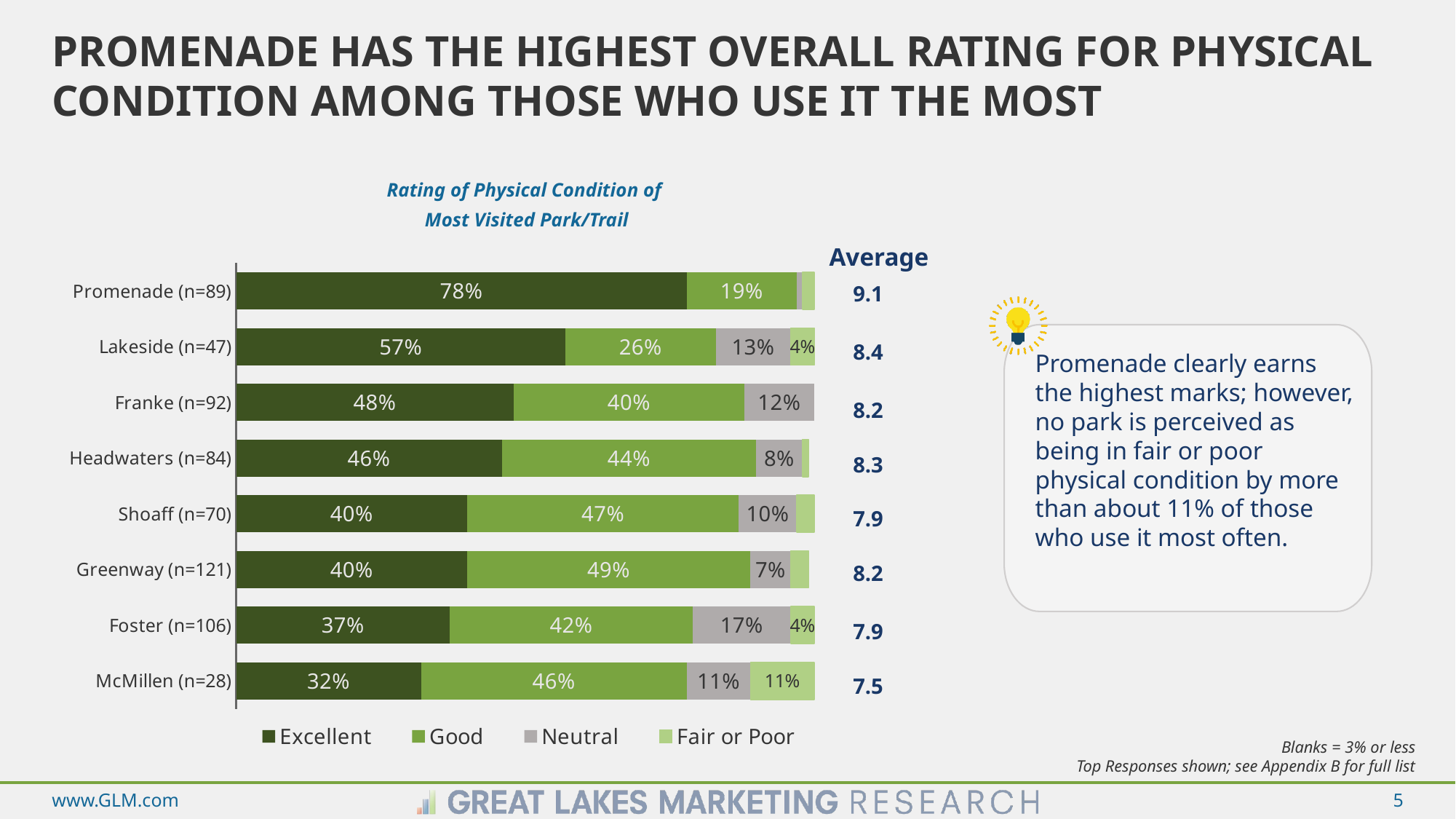
How many series does the legend list? 4 What type of chart is shown on the slide? Stacked bar chart What is the title of the chart? Rating of Physical Condition of Most Visited Park/Trail What percentage of McMillen users rated its physical condition as Fair or Poor? 11% Which park has the highest Excellent percentage? Promenade (n=89) How many percentage points higher is Promenade's Excellent rating than Lakeside's Excellent rating? 21 percentage points Which park has the lowest Excellent percentage? McMillen (n=28) How many parks/trails are shown in the chart? 8 What percentage of Promenade users rated its physical condition as Excellent? 78% What is the total of the Lakeside bar (Excellent + Good + Neutral + Fair or Poor)? 100% Which has a larger Good percentage, Greenway or Shoaff? Greenway What is the Neutral percentage for Lakeside (n=47)? 13%